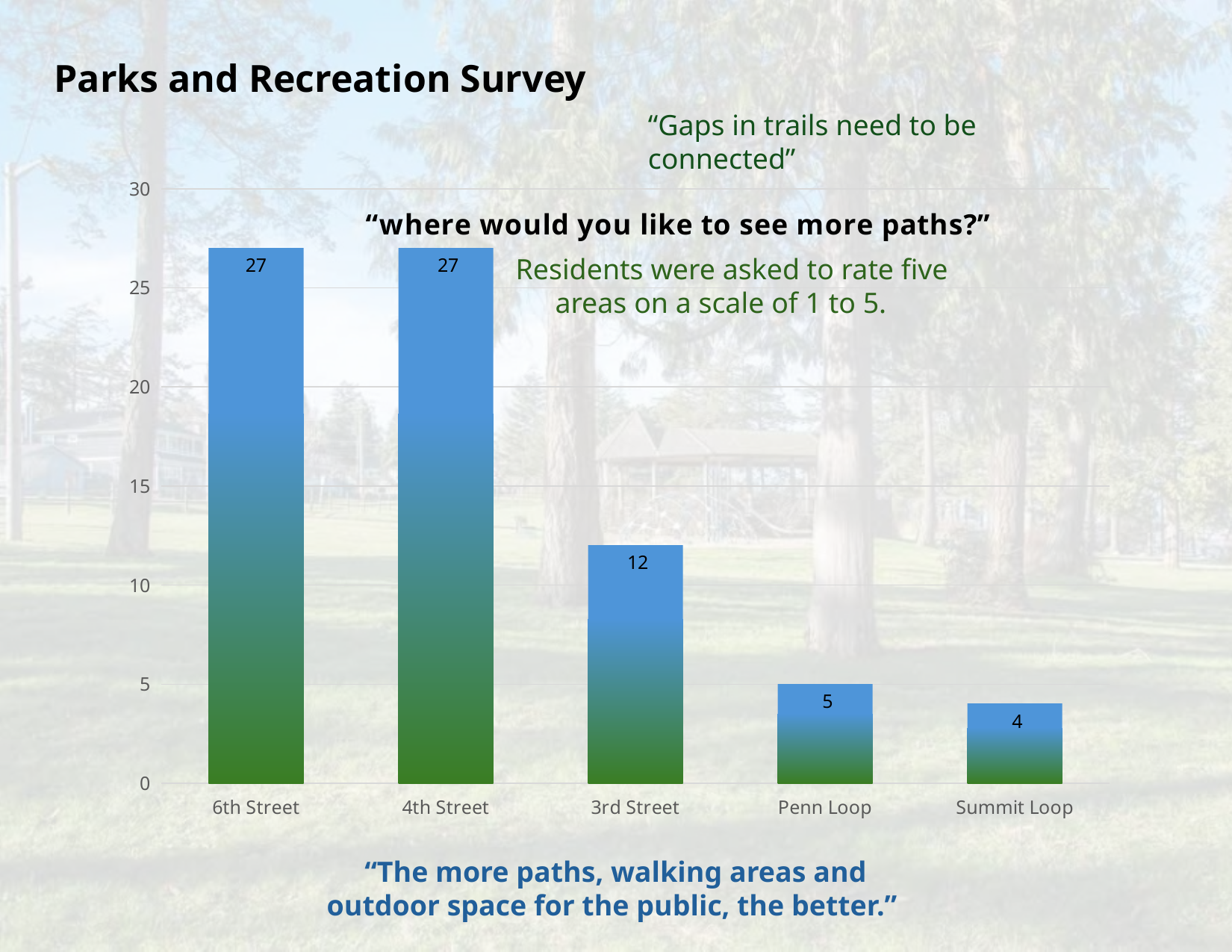
What kind of chart is shown on the slide? bar chart What is the difference between the values for Penn Loop and Summit Loop? 1 What is the value for 3rd Street? 12 Which is larger, the value for 3rd Street or the value for Penn Loop? 3rd Street How many categories are shown on the x axis? 5 What is the value for 6th Street? 27 What is the value for Summit Loop? 4 Which category has the lowest value? Summit Loop What is the difference between the values for 4th Street and 3rd Street? 15 What is the title of the slide? Parks and Recreation Survey What is the value for Penn Loop? 5 Is the value for 3rd Street greater or less than 10? greater